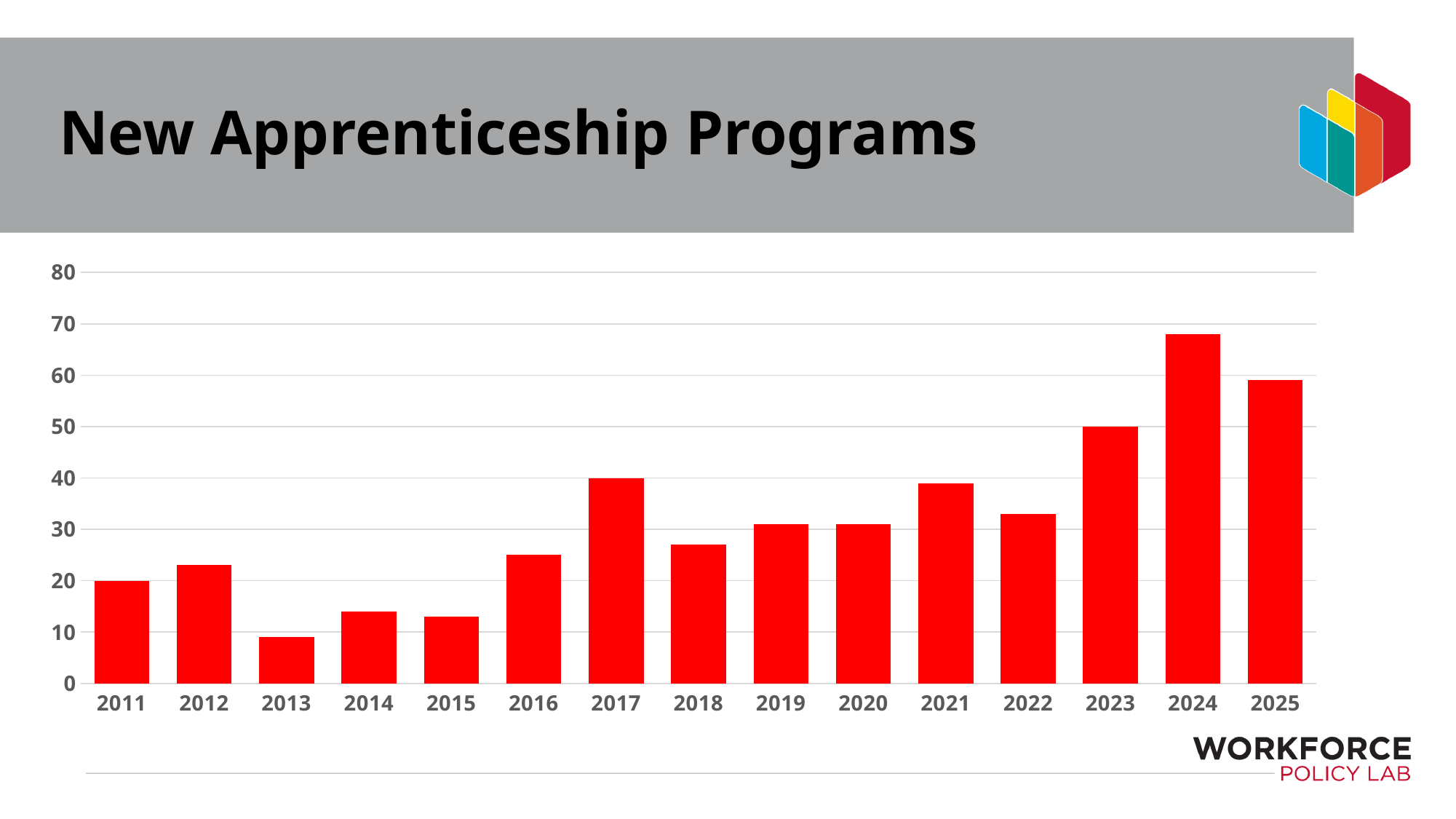
Is the value for 2013 greater or less than 10? less What is the value for 2023? 50 Which year has the highest number of new apprenticeship programs? 2024 Which year has the larger value, 2021 or 2022? 2021 What is the value for 2017? 40 Is the value for 2024 greater or less than 60? greater What is the difference between the values for 2017 and 2011? 20 How many years are shown on the x axis of the chart? 15 What is the title of the chart? New Apprenticeship Programs What is the value for 2011? 20 Which year has the lowest number of new apprenticeship programs? 2013 What kind of chart is shown on the slide? bar chart